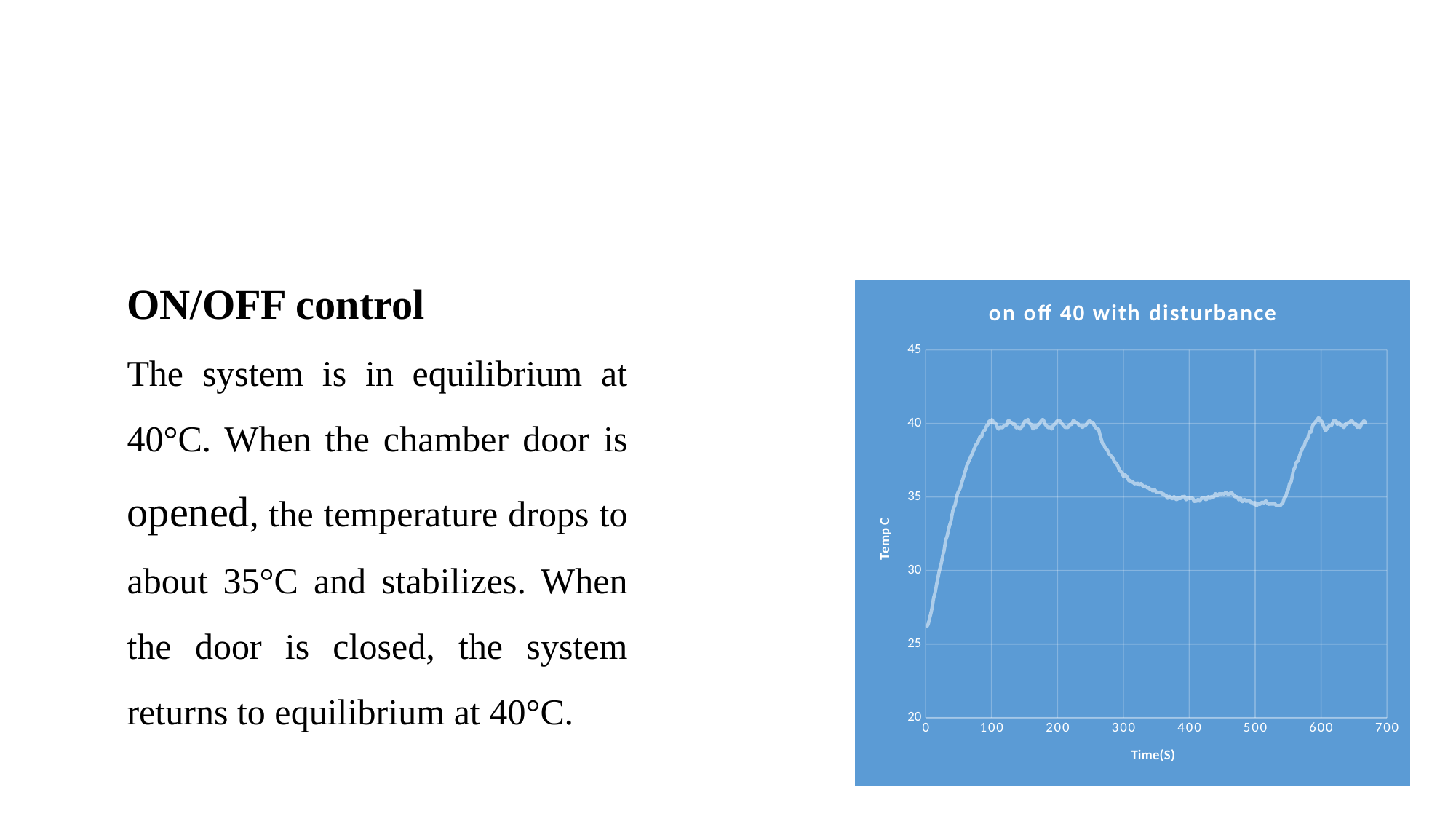
Is the temperature at time 300 greater or less than 40? less What kind of chart is shown on the slide? line chart Does the temperature rise or fall between time 550 and time 600? rise Is the temperature at time 50 greater or less than 30? greater Does the temperature rise or fall between time 0 and time 100? rise What is the label of the x axis of the chart? Time(S) Is the temperature at time 400 greater or less than 40? less What is the title of the chart? on off 40 with disturbance Does the temperature rise or fall between time 250 and time 300? fall